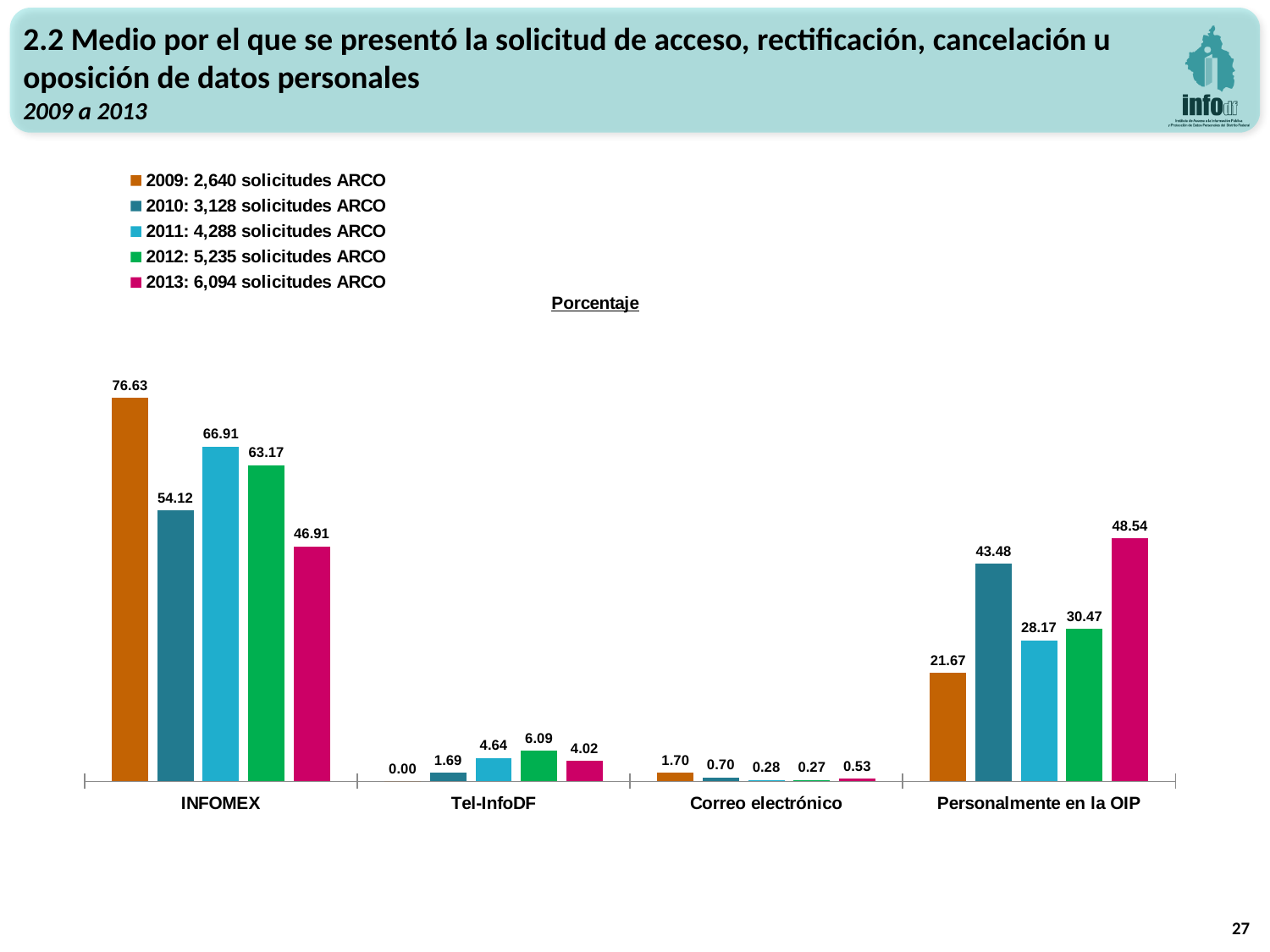
What kind of chart is shown on the slide? bar chart Which legend entry is shown in orange? 2009: 2,640 solicitudes ARCO What is the value for Correo electrónico in the 2011 series? 0.28 How many series does the legend list? 5 What is the difference between the 2009 and 2013 values for INFOMEX? 29.72 What is the value for Personalmente en la OIP in the 2013 series? 48.54 Which is larger for Personalmente en la OIP: the 2010 value or the 2011 value? 2010 What is the value for INFOMEX in the 2009 series? 76.63 Which category has the lowest value in the 2009 series? Tel-InfoDF How many categories are shown on the x axis? 4 What is the value for Tel-InfoDF in the 2012 series? 6.09 Which category has the highest value in the 2013 series? Personalmente en la OIP